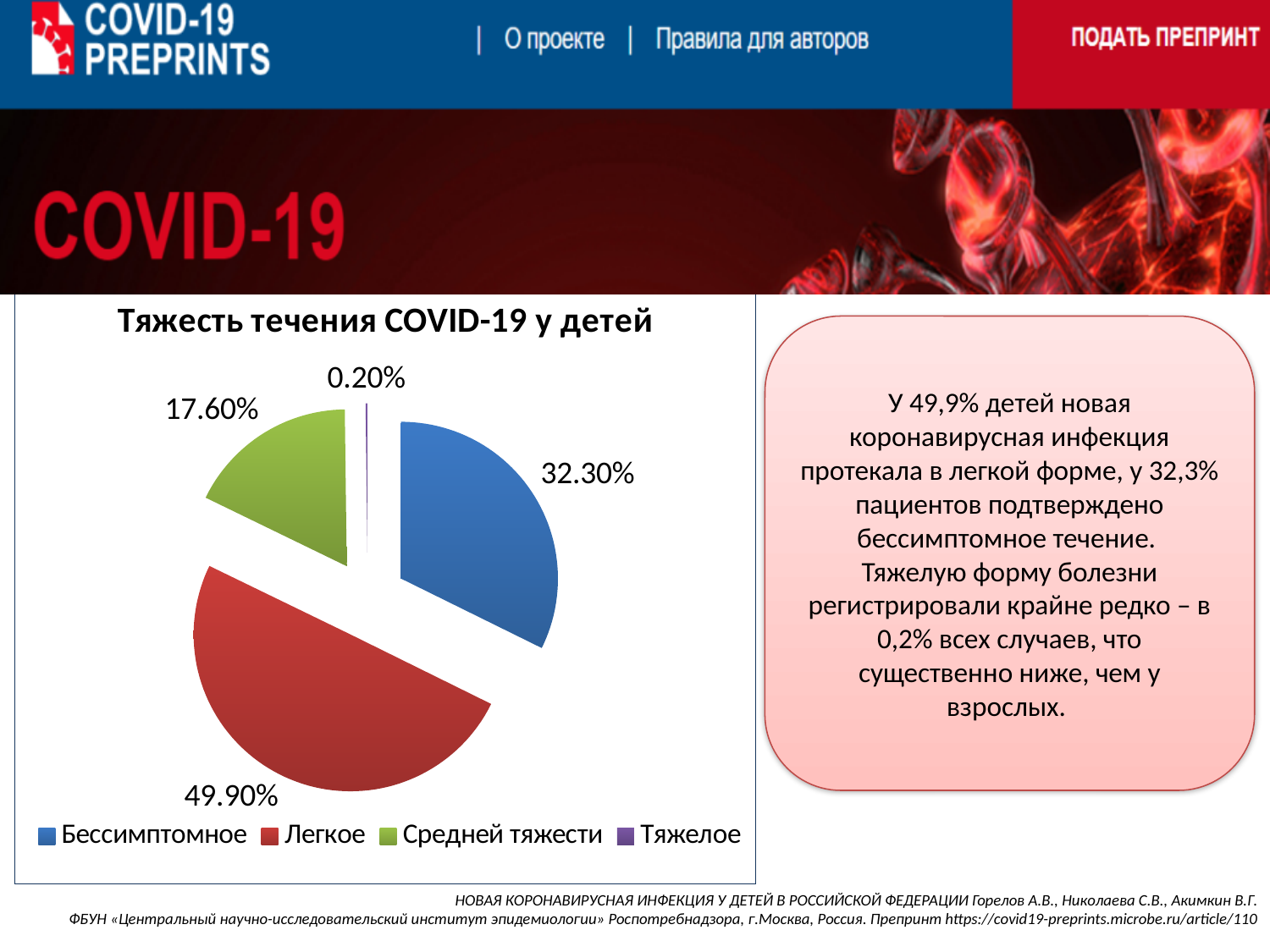
What type of chart is shown on the slide? Pie chart Which is larger, the Бессимптомное share or the Средней тяжести share? Бессимптомное How many slices does the pie chart have? 4 What percentage does the Тяжелое slice show? 0.20% What is the title of the chart? Тяжесть течения COVID-19 у детей What is the difference between the Легкое and Бессимптомное shares? 17.60% What percentage does the Средней тяжести slice show? 17.60% Which category has the largest share of the pie? Легкое Which category has the smallest share of the pie? Тяжелое How many entries does the legend list? 4 What percentage does the Легкое slice show? 49.90% What percentage does the Бессимптомное slice show? 32.30%